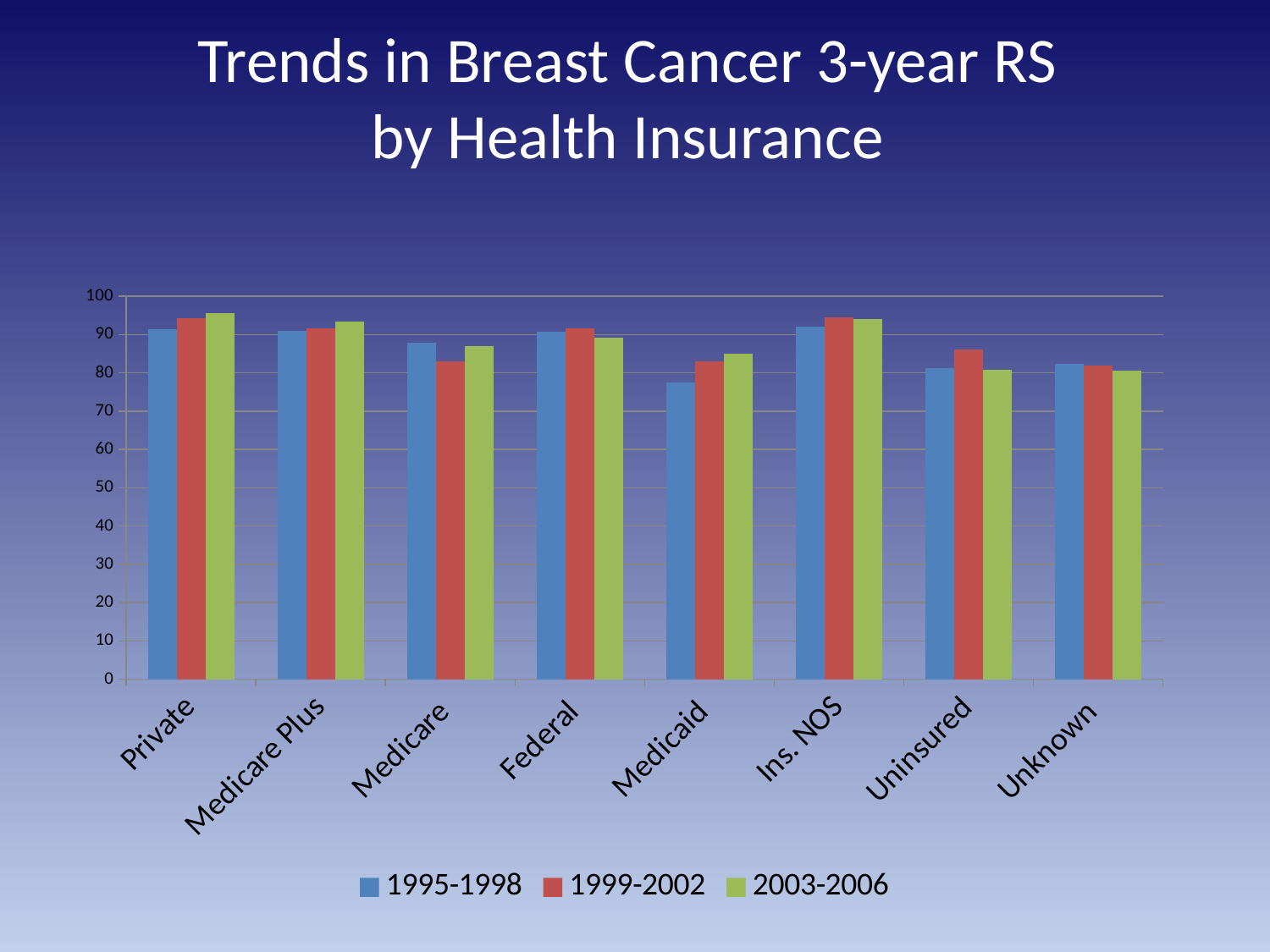
Is the 2003-2006 value for Private greater or less than 90? greater Is the 1995-1998 value for Ins. NOS greater or less than 90? greater Which category has the lowest value for the 1995-1998 series? Medicaid How many series does the legend list? 3 Do the values for Medicaid rise or fall from 1995-1998 to 2003-2006? rise What are the three series listed in the legend? 1995-1998, 1999-2002, 2003-2006 What kind of chart is shown on the slide? bar chart Is the 1999-2002 value for Medicare greater or less than 90? less For Medicaid, which is larger: the 1995-1998 value or the 2003-2006 value? 2003-2006 For the 1999-2002 series, which is larger: Uninsured or Unknown? Uninsured How many health insurance categories are shown on the x axis? 8